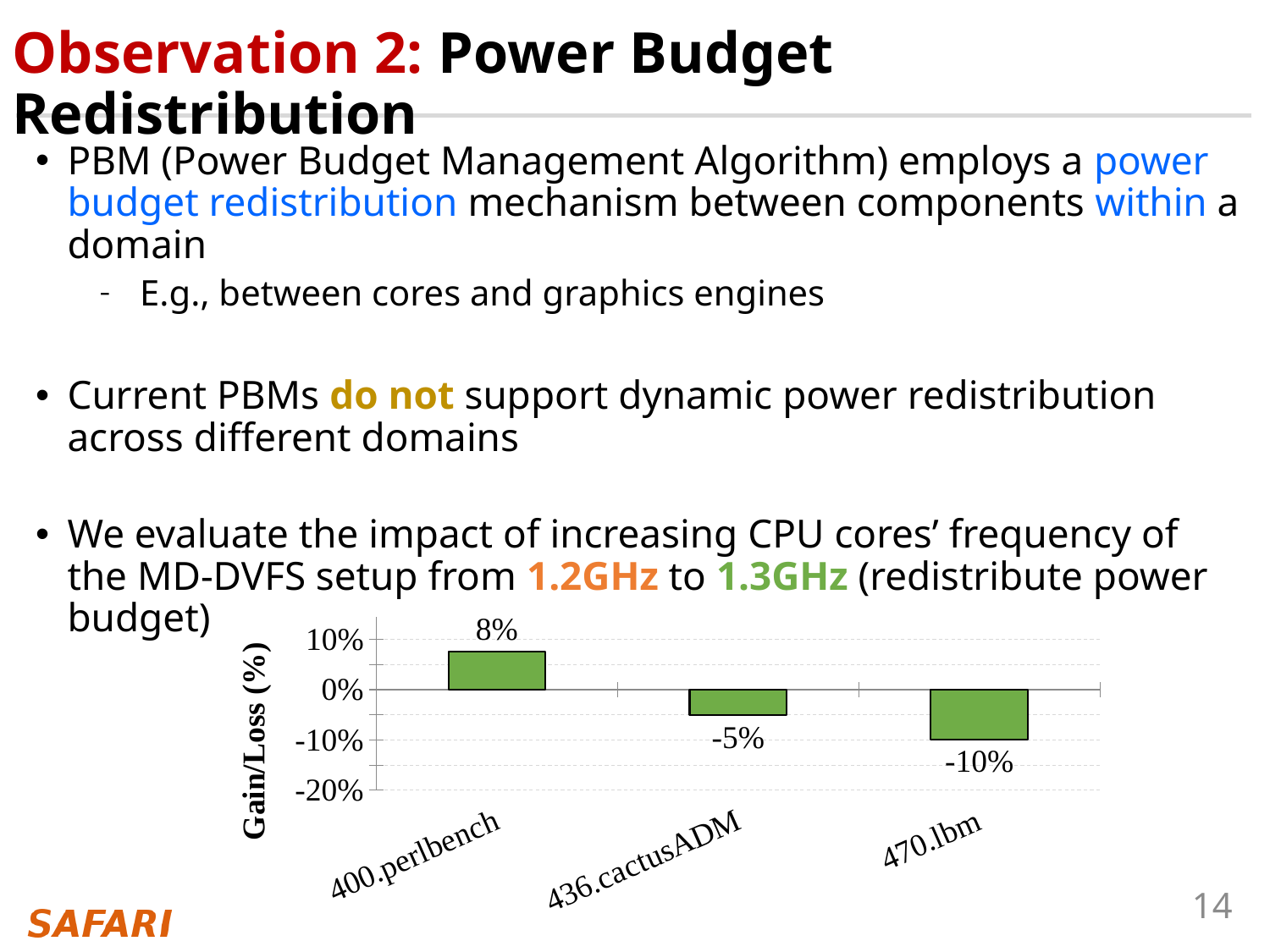
Which benchmark has the lowest Gain/Loss value? 470.lbm What is the Gain/Loss value for 436.cactusADM? -5% How many benchmarks are shown in the chart? 3 What is the label of the vertical axis of the chart? Gain/Loss (%) Which benchmark has the highest Gain/Loss value? 400.perlbench Do the Gain/Loss values rise or fall from 400.perlbench to 470.lbm? fall What kind of chart is shown on the slide? bar chart What is the Gain/Loss value for 470.lbm? -10% What is the difference between the Gain/Loss values for 400.perlbench and 470.lbm? 18% What is the Gain/Loss value for 400.perlbench? 8% What is the difference between the Gain/Loss values for 436.cactusADM and 470.lbm? 5% Which has a larger Gain/Loss value, 436.cactusADM or 470.lbm? 436.cactusADM